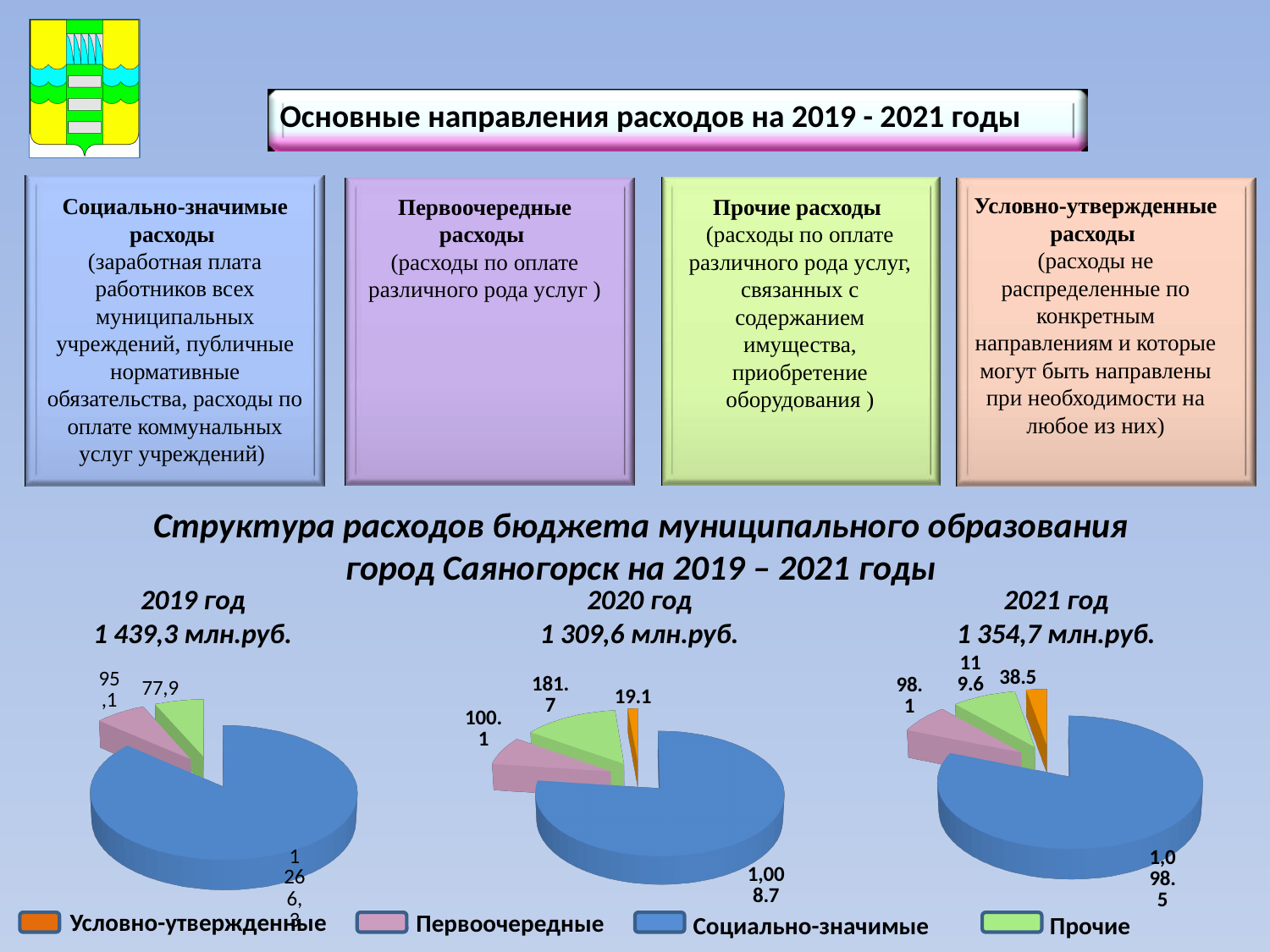
In the 2021 год pie chart, which category has the largest slice? Социально-значимые In the 2021 год pie chart, what is the difference between the values for Прочие and Первоочередные? 21.5 In the 2021 год pie chart, what is the value for Социально-значимые? 1,098.5 In the 2020 год pie chart, what is the value for Прочие? 181.7 What kind of chart is used to show the budget expenditure structure for 2019, 2020 and 2021? pie chart In the 2020 год pie chart, which category has the smallest slice? Условно-утвержденные How many categories does the shared legend below the pie charts list? 4 What total amount is shown above the 2020 год pie chart? 1 309,6 млн.руб. In the 2021 год pie chart, what is the value for Первоочередные? 98.1 In the 2019 год pie chart, which is larger: Первоочередные or Прочие? Первоочередные In the 2020 год pie chart, what is the value for Условно-утвержденные? 19.1 In the 2019 год pie chart, what is the value for Первоочередные? 95,1